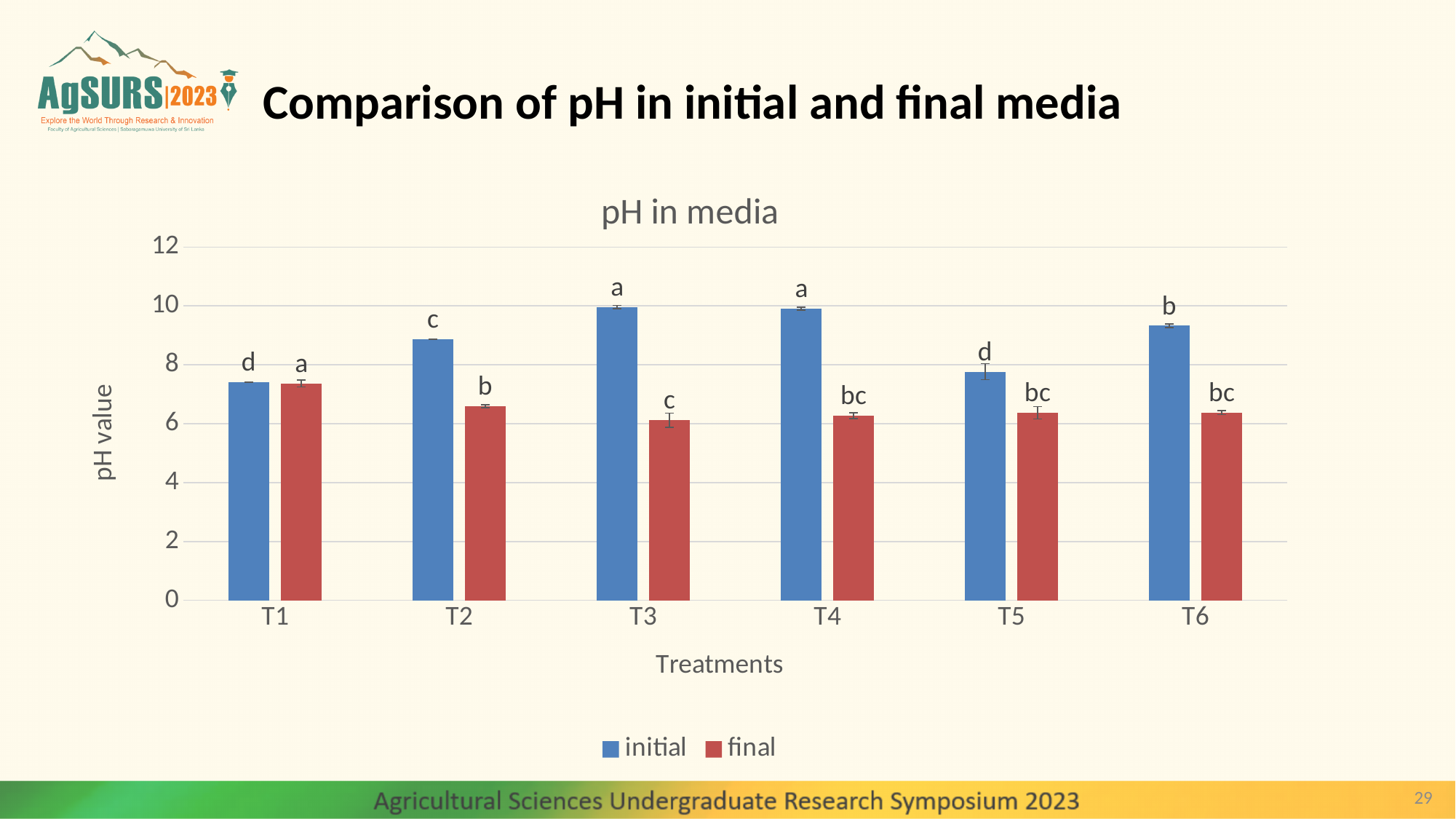
What kind of chart is shown on the slide? bar chart What is the title of the chart? pH in media Is the initial pH value for T3 greater or less than 8? greater How many series does the chart legend list? 2 What label is shown on the y axis of the chart? pH value For T3, which is larger, the initial pH or the final pH? initial Is the final pH value for T3 greater or less than 8? less How many treatments are shown on the x axis of the chart? 6 For T4, which is larger, the initial pH or the final pH? initial Is the initial pH value for T6 greater or less than 8? greater Which treatment has the highest final pH value? T1